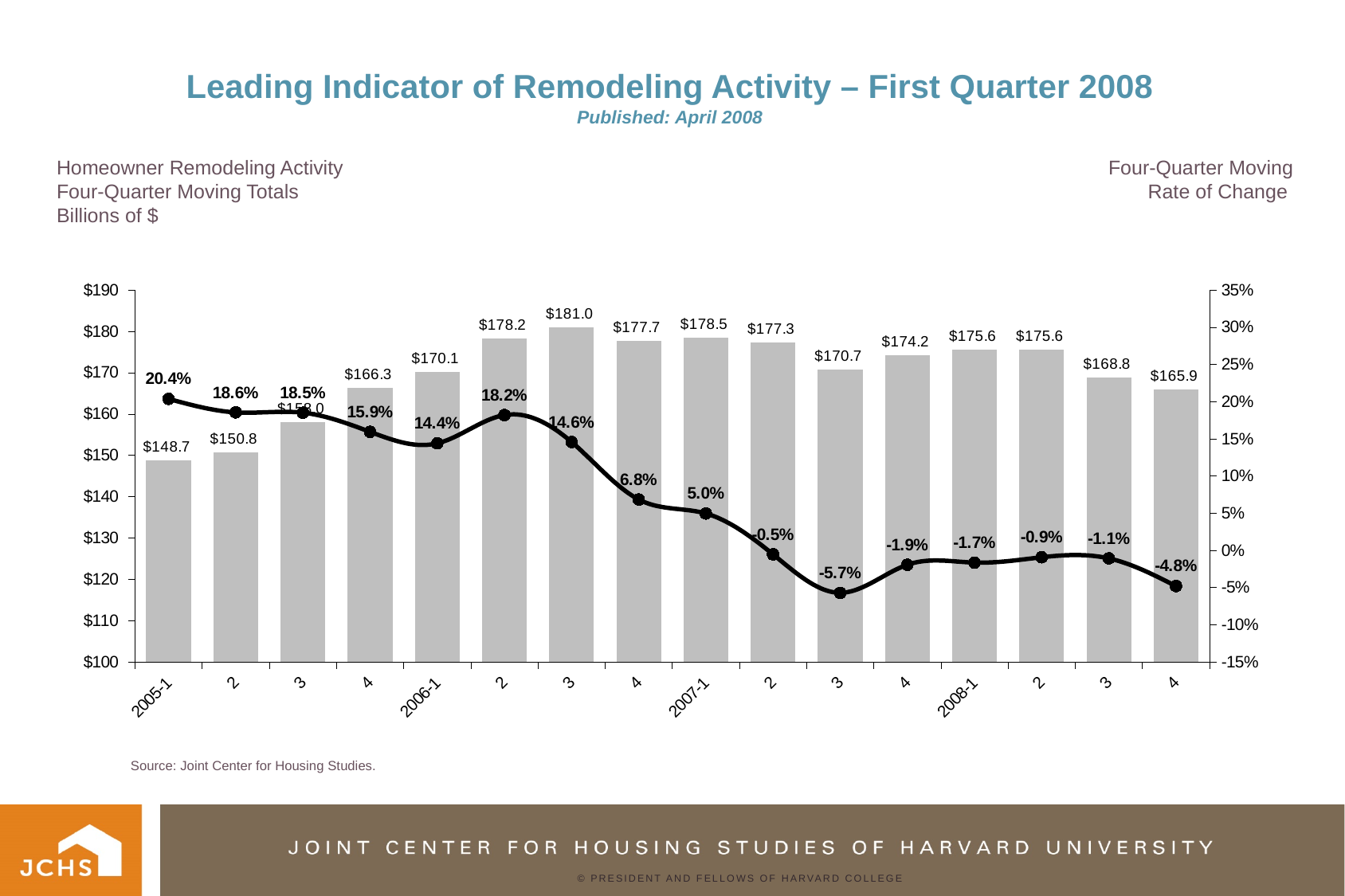
Which quarter has the lowest four-quarter moving rate of change on the line? 2007-3 What is the difference between the four-quarter moving totals for 2006-3 and 2005-1? $32.3 Does the four-quarter moving rate of change line generally rise or fall from 2005-1 to 2008-4? Fall What is the four-quarter moving rate of change (line value) for 2007-3, the third quarter of 2007? -5.7% What is the four-quarter moving total (bar value) for 2008-4, the fourth quarter of 2008? $165.9 Which is larger, the four-quarter moving total for 2007-1 or for 2007-4? 2007-1 What kind of chart is shown on the slide? Combined bar and line chart Which quarter has the highest four-quarter moving total (tallest bar)? 2006-3 What is the four-quarter moving total (bar value) for 2006-3, the third quarter of 2006? $181.0 Which quarter has the lowest four-quarter moving total (shortest bar)? 2005-1 How many quarters are plotted along the x axis? 16 What is the four-quarter moving rate of change (line value) for 2005-1? 20.4%